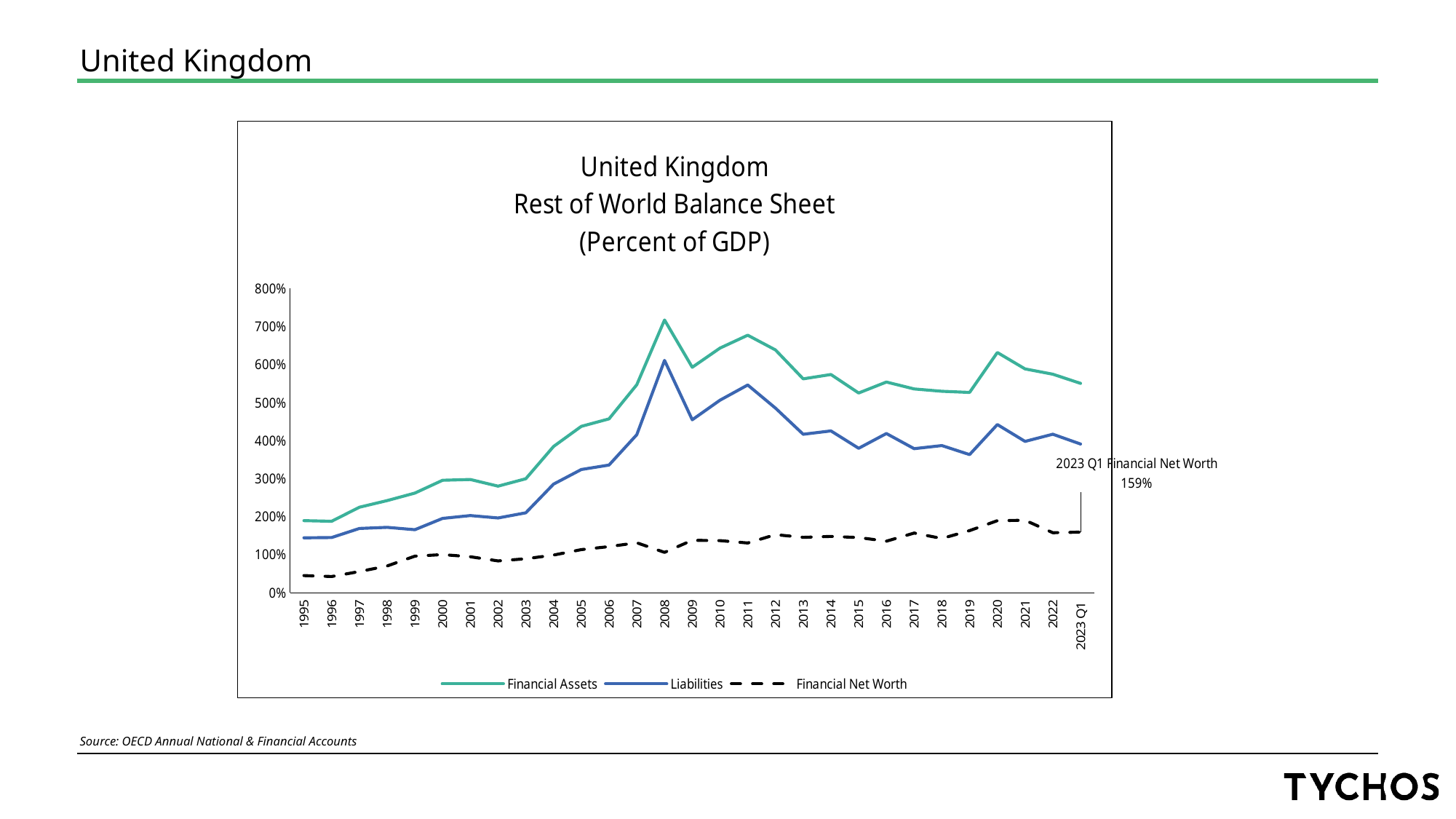
Is the value for Financial Assets in 2008 greater or less than 700%? greater In which year does Liabilities reach its highest value? 2008 In which year does Financial Assets reach its highest value? 2008 Is the value for Financial Net Worth in 2008 greater or less than 150%? less How many series does the legend list? 3 What kind of chart is shown on the slide? Line chart Which series is drawn with a dashed line? Financial Net Worth Do Financial Assets rise or fall from 1995 to 2008? Rise What is the value of Financial Net Worth in 2023 Q1? 159% Which is larger in 2011, Financial Assets or Liabilities? Financial Assets Is the value for Liabilities in 1995 greater or less than 200%? less How many time points are plotted along the x axis? 29